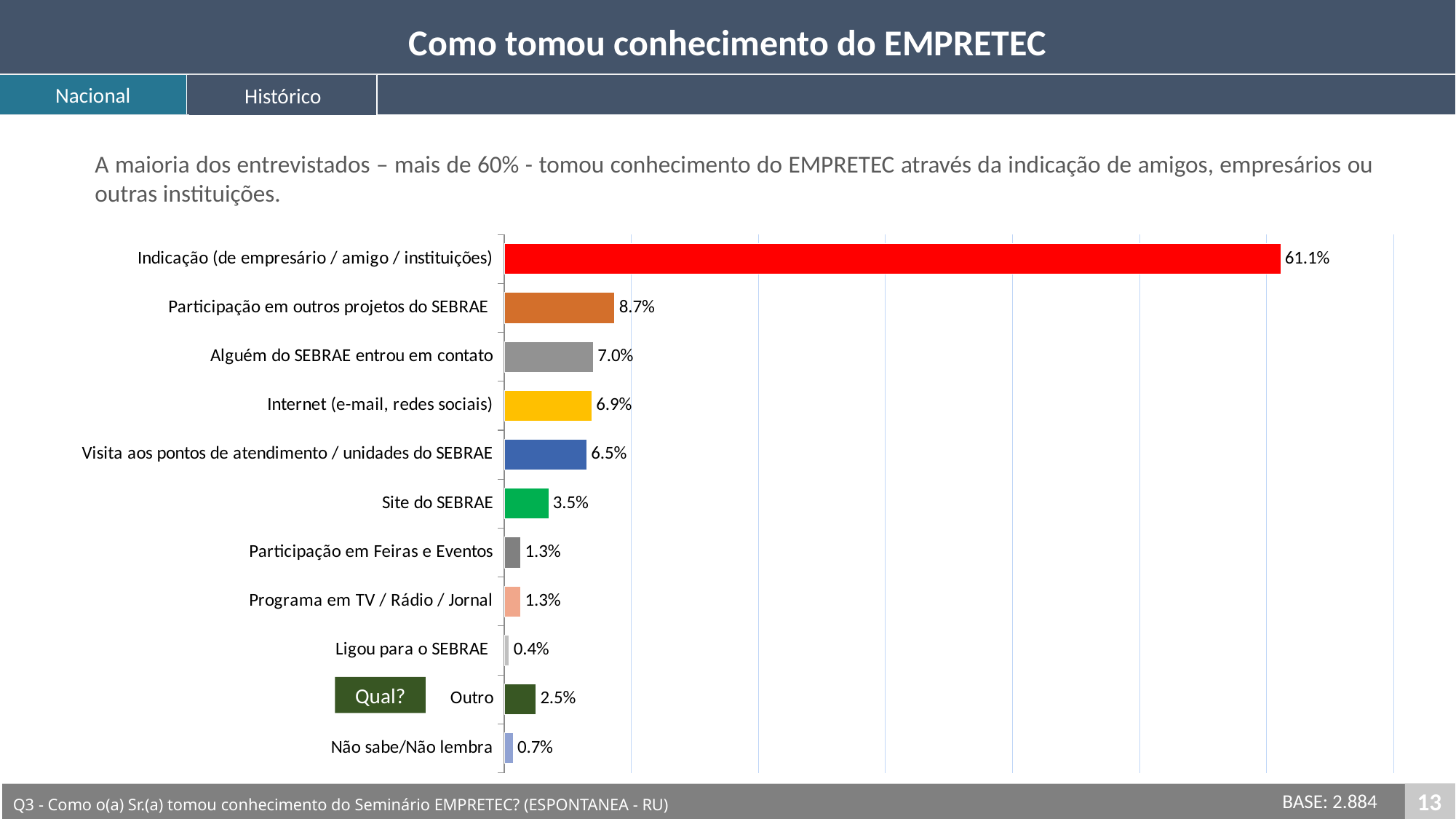
What is the value for 'Outro'? 2.5% What is the value for 'Site do SEBRAE'? 3.5% Which category has the lowest value? Ligou para o SEBRAE What is the value for 'Internet (e-mail, redes sociais)'? 6.9% What percentage of respondents learned about EMPRETEC through 'Indicação (de empresário / amigo / instituições)'? 61.1% What is the difference between 'Participação em outros projetos do SEBRAE' and 'Visita aos pontos de atendimento / unidades do SEBRAE'? 2.2 percentage points What is the base (number of respondents) shown at the bottom of the slide? 2.884 What is the difference between 'Indicação (de empresário / amigo / instituições)' and 'Participação em outros projetos do SEBRAE'? 52.4 percentage points What kind of chart is shown on the slide? Bar chart Which category has the highest value? Indicação (de empresário / amigo / instituições) How many categories are shown in the chart? 11 Which is larger, 'Site do SEBRAE' or 'Participação em Feiras e Eventos'? Site do SEBRAE